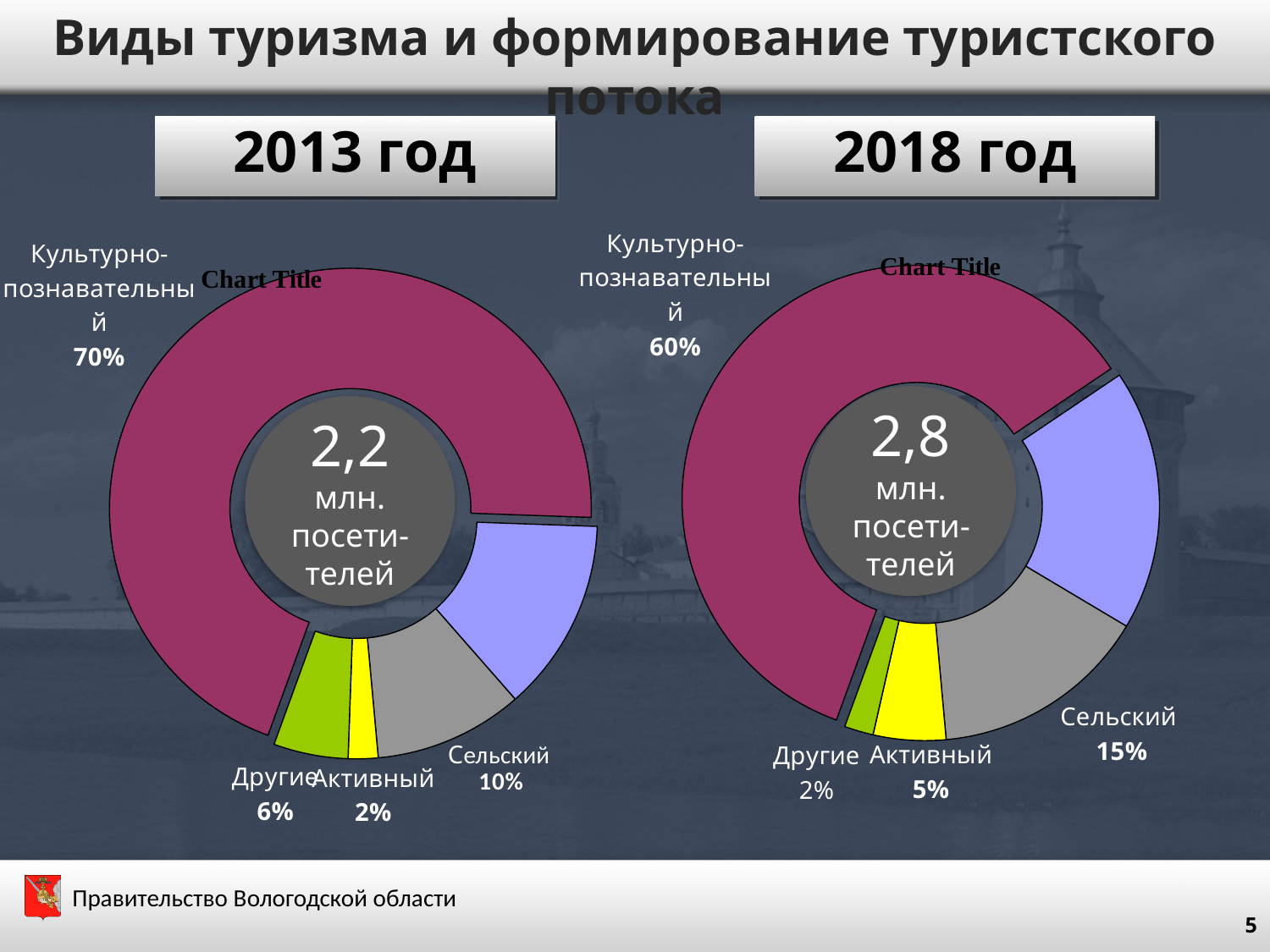
In the 2013 год chart, what share is shown for Сельский tourism? 10% In the 2018 год chart, what share is shown for Другие? 2% By how many percentage points did the share of Культурно-познавательный tourism change from the 2013 год chart to the 2018 год chart? 10 percentage points (70% to 60%) In the 2018 год chart, what share is shown for Культурно-познавательный tourism? 60% What total number of visitors is shown in the centre of the 2018 год chart? 2,8 млн. посетителей In the 2013 год chart, what share is shown for Культурно-познавательный tourism? 70% In the 2013 год chart, which labelled category has the largest share? Культурно-познавательный Which is larger: the share of Сельский tourism in the 2013 год chart or in the 2018 год chart? 2018 год (15%) In the 2013 год chart, what share is shown for Активный tourism? 2% In the 2013 год chart, which labelled category has the smallest share? Активный In the 2018 год chart, what share is shown for Сельский tourism? 15% What type of chart is used for the 2013 год data? Doughnut (pie) chart